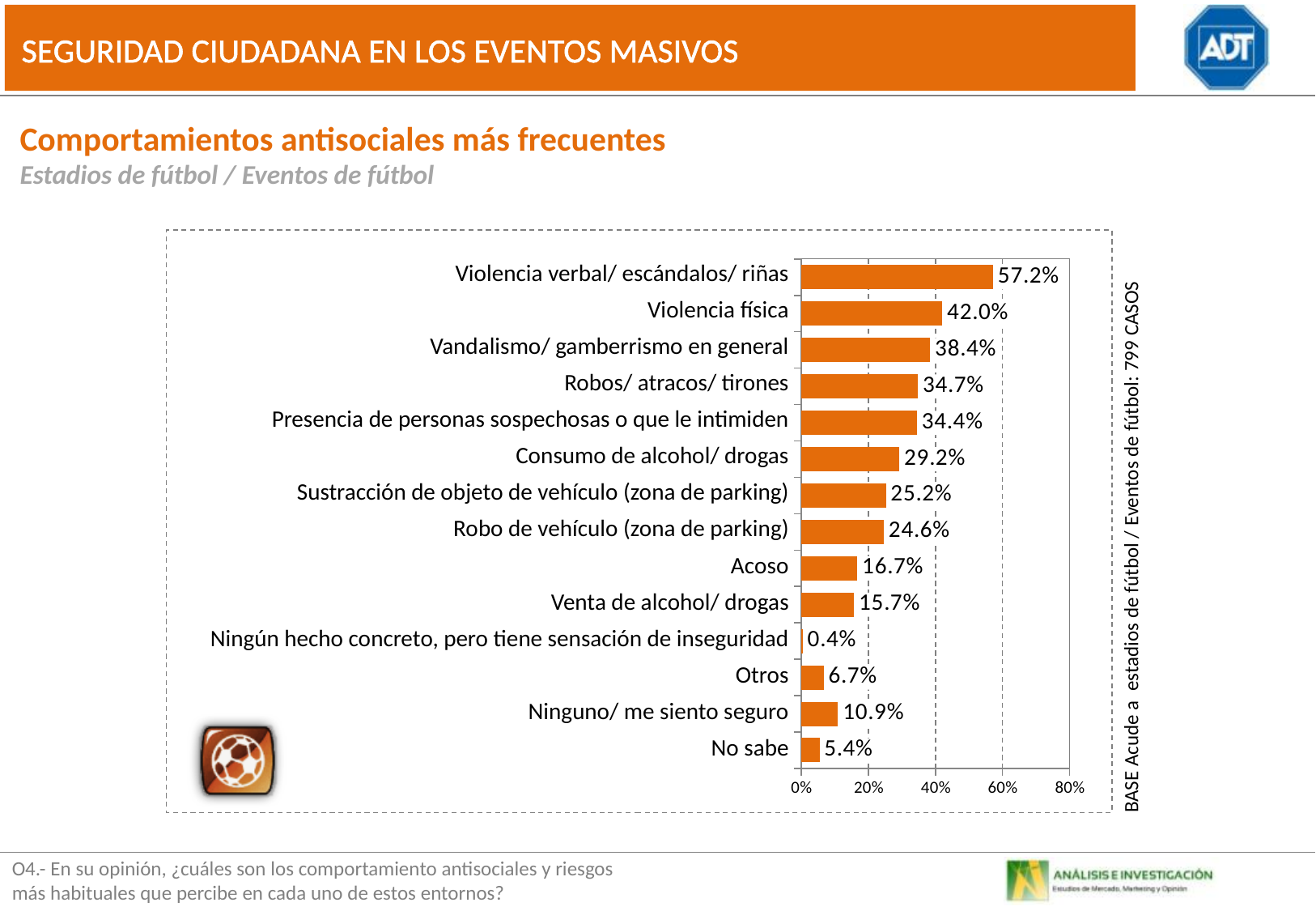
Which category has the highest value? Violencia verbal/ escándalos/ riñas What is the base (number of cases) stated beside the chart? 799 CASOS What is the value for Ninguno/ me siento seguro? 10.9% What is the value for Violencia física? 42.0% What is the difference between Violencia verbal/ escándalos/ riñas and Violencia física? 15.2% What is the difference between Acoso and Venta de alcohol/ drogas? 1.0% Which is larger, Robos/ atracos/ tirones or Vandalismo/ gamberrismo en general? Vandalismo/ gamberrismo en general How many categories are shown in the chart? 14 Which category has the lowest value? Ningún hecho concreto, pero tiene sensación de inseguridad What kind of chart is shown on the slide? bar chart Is the value for Sustracción de objeto de vehículo (zona de parking) greater or less than 20%? greater What is the value for Consumo de alcohol/ drogas? 29.2%